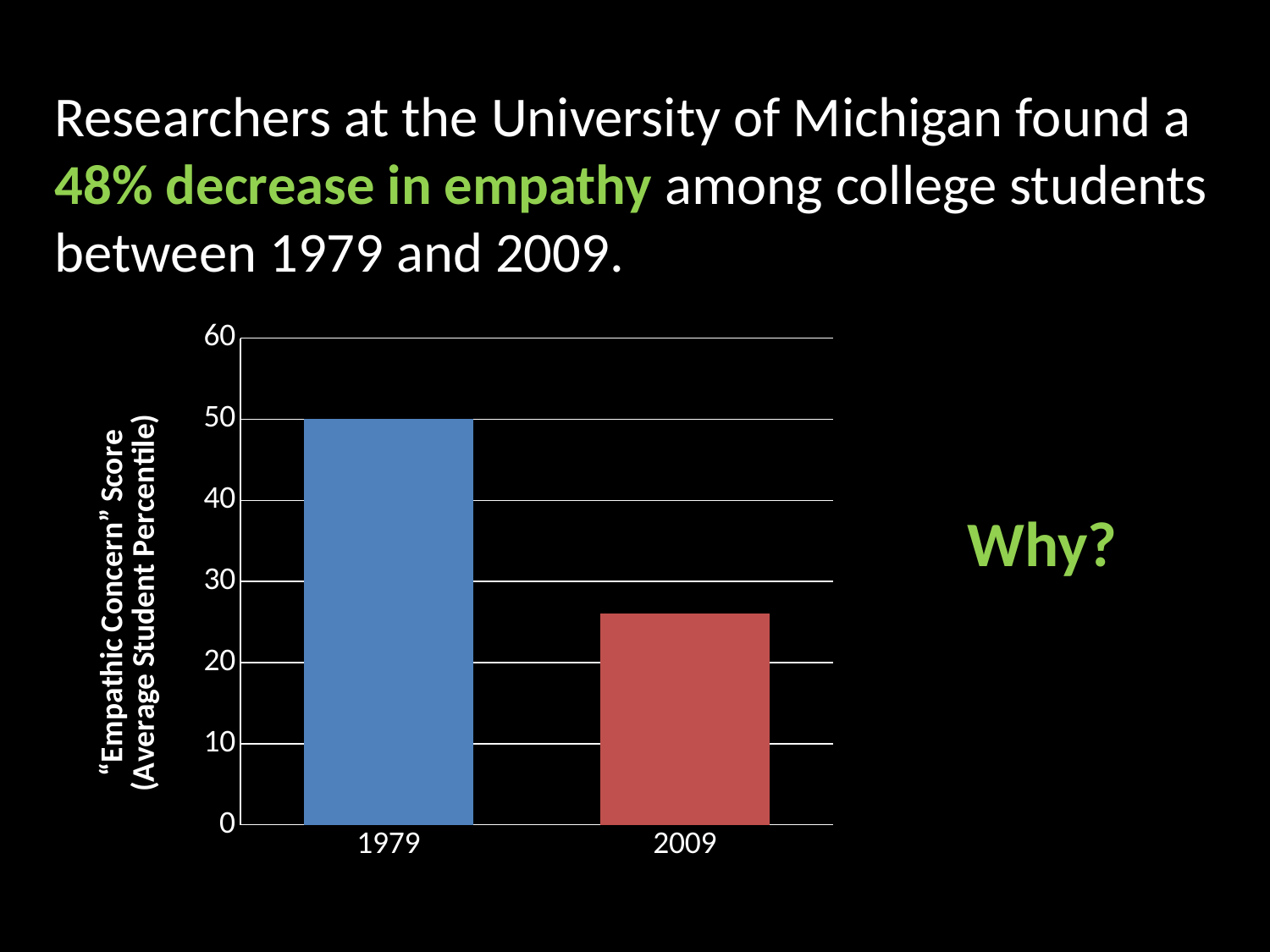
Do the values rise or fall from 1979 to 2009? fall Which year has the higher "Empathic Concern" score? 1979 What is the label on the vertical axis of the chart? "Empathic Concern" Score (Average Student Percentile) Is the value for 2009 greater or less than 20? greater What is the value for 1979 on the chart? 50 What is the highest value shown on the vertical axis? 60 How many bars (categories) does the chart show? 2 What kind of chart is shown on the slide? bar chart Which year has the lower "Empathic Concern" score? 2009 Is the value for 1979 greater or less than 40? greater Is the value for 2009 greater or less than 30? less Is the value for 1979 larger or smaller than the value for 2009? larger